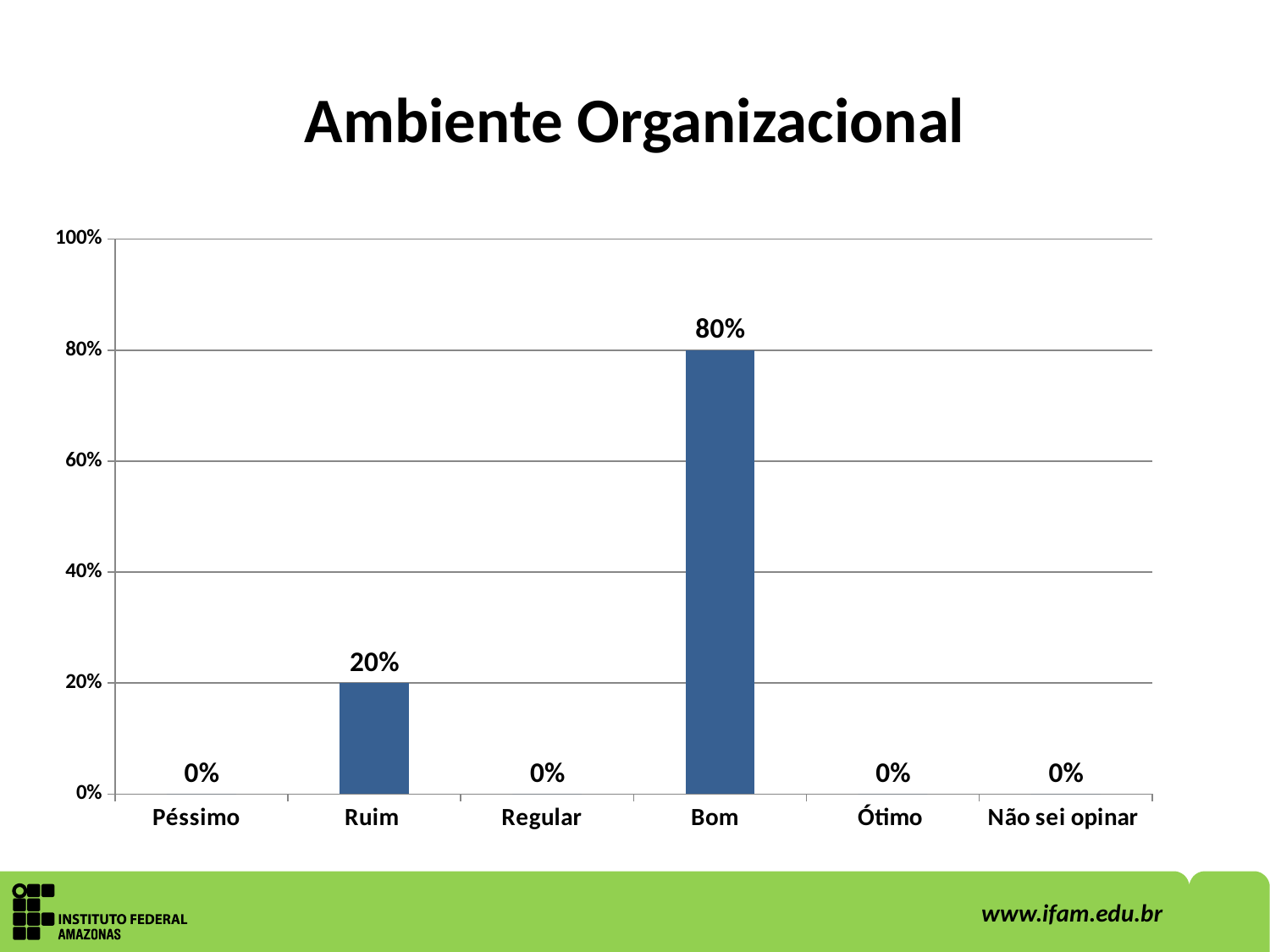
What kind of chart is shown on the slide? bar chart What is the difference between the values for Bom and Ruim? 60% What is the value for Bom? 80% What is the value for Não sei opinar? 0% Is the value for Bom greater or less than 60%? greater How many categories have a value of 0%? 4 How many categories are shown on the x axis? 6 What is the value for Regular? 0% Which category has the highest value? Bom What is the title of the chart? Ambiente Organizacional What is the value for Ruim? 20% Which is larger, the value for Ruim or the value for Bom? Bom